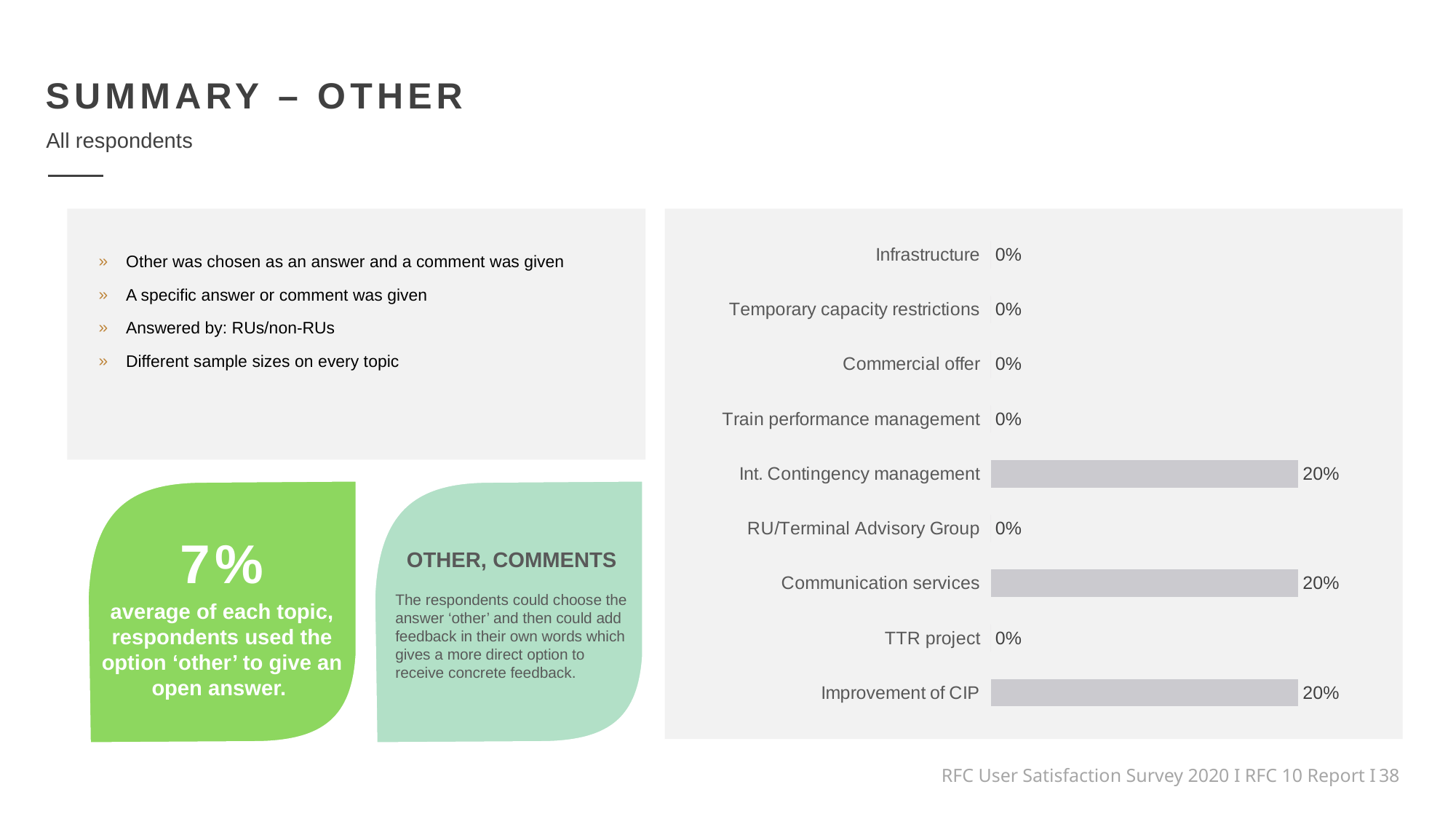
How many categories are shown in the chart? 9 What is the value for Train performance management? 0% What is the value for Infrastructure? 0% Which is larger, the value for Commercial offer or the value for Communication services? Communication services What is the value for Communication services? 20% What is the value for Improvement of CIP? 20% What kind of chart is shown on the slide? bar chart What is the value for Temporary capacity restrictions? 0% How many categories have a value of 20%? 3 What is the difference between the values for Improvement of CIP and RU/Terminal Advisory Group? 20% What is the value for Int. Contingency management? 20% What is the value for TTR project? 0%